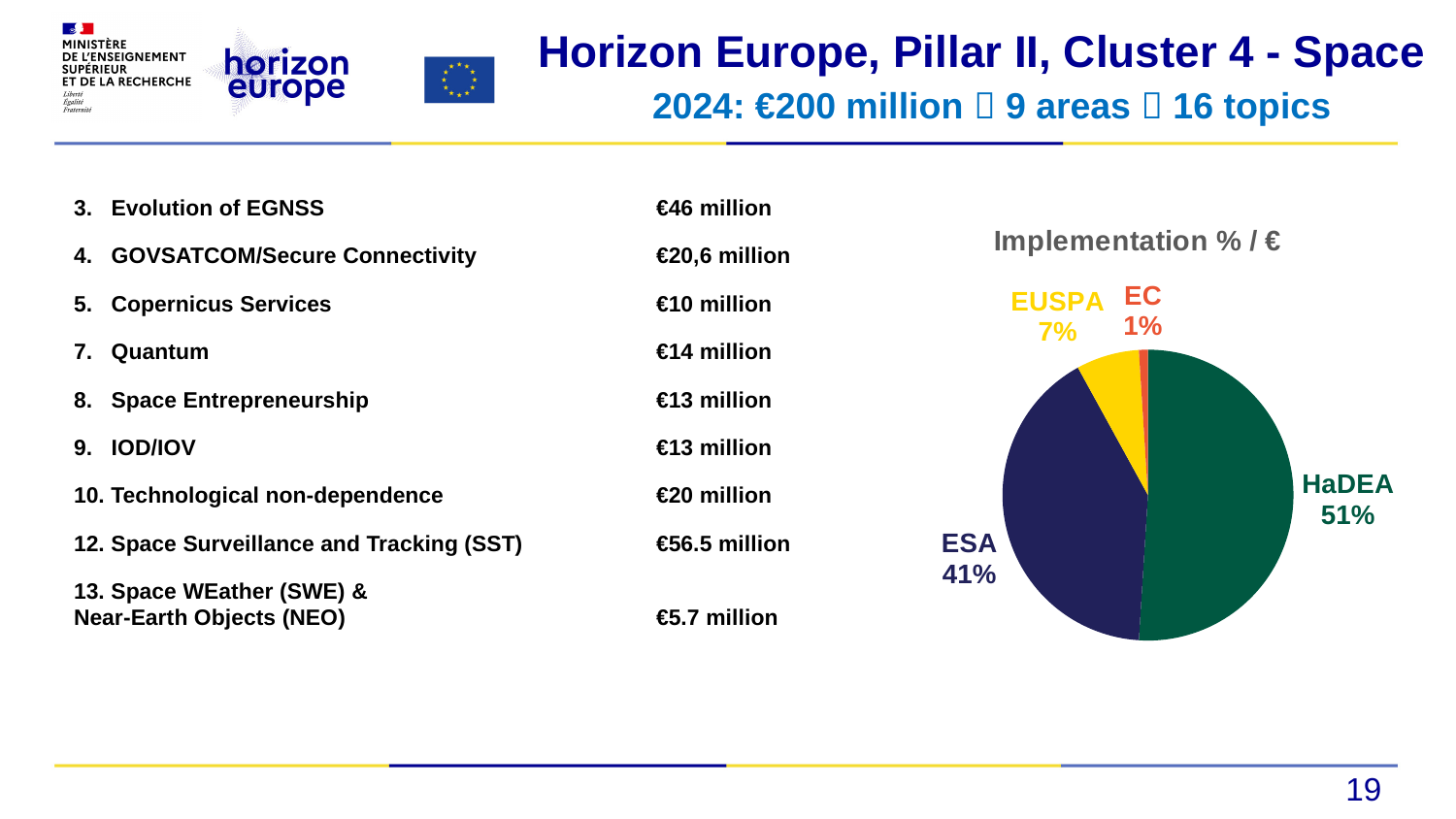
What share of the pie does HaDEA hold? 51% How many slices does the pie chart have? 4 What share of the pie does EUSPA hold? 7% What colour is the HaDEA slice of the pie? green What share of the pie does EC hold? 1% What is the difference in percentage points between the HaDEA and ESA slices? 10 Which slice of the pie is the smallest? EC What kind of chart is shown on the slide? pie chart What is the title of the chart? Implementation % / € Which slice of the pie is the largest? HaDEA Which is larger, the EUSPA slice or the EC slice? EUSPA